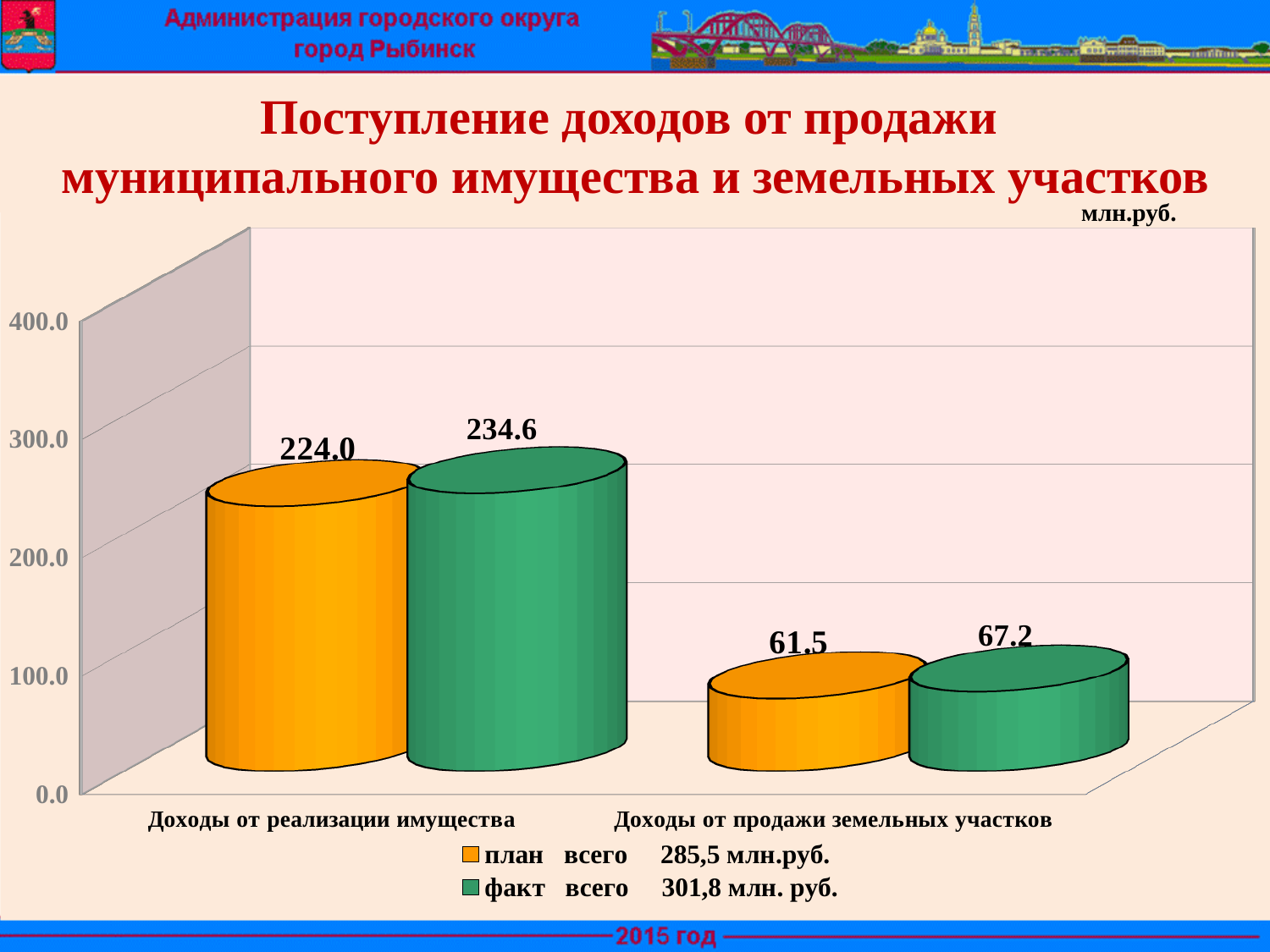
How many series does the legend list? 2 How many categories are shown on the x axis? 2 What is the difference between the fact and plan values for Доходы от реализации имущества? 10.6 Which category has the lowest plan value? Доходы от продажи земельных участков What kind of chart is shown on the slide? bar chart What is the plan value for Доходы от продажи земельных участков? 61.5 Which is larger for Доходы от продажи земельных участков: the plan value or the fact value? факт What is the fact value for Доходы от реализации имущества? 234.6 What is the plan value for Доходы от реализации имущества? 224.0 What is the fact value for Доходы от продажи земельных участков? 67.2 Which category has the highest fact value? Доходы от реализации имущества What is the difference between the fact and plan values for Доходы от продажи земельных участков? 5.7